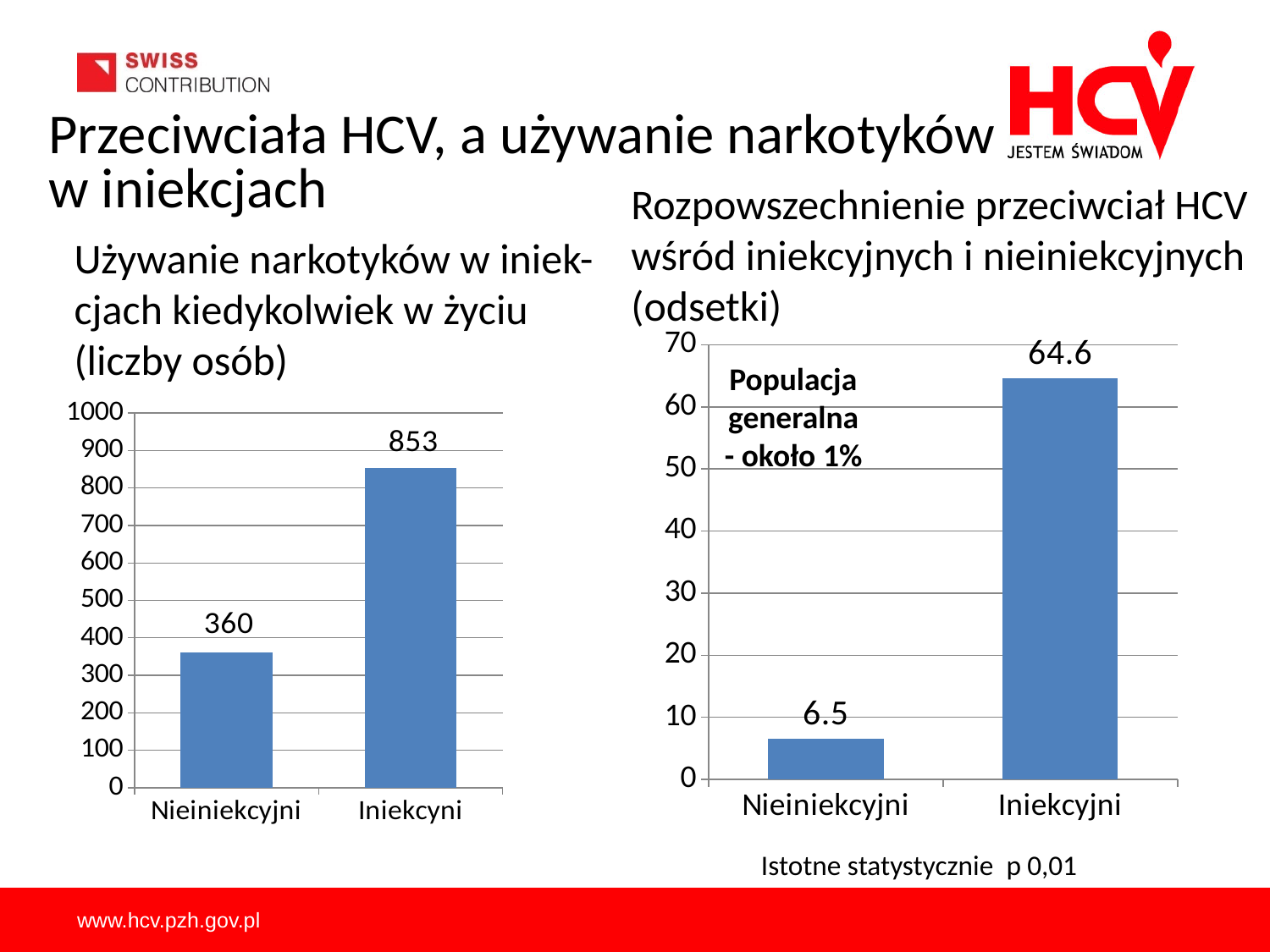
In the right chart, what does the text box inside the plot area say? Populacja generalna - około 1% In the left chart, what is the difference between the values for Iniekcyni and Nieiniekcyjni? 493 In the right chart, is the value for Iniekcyjni greater or less than 60? greater In the left chart, which category has the highest value? Iniekcyni In the right chart (Rozpowszechnienie przeciwciał HCV), what is the value for Iniekcyjni? 64.6 In the left chart (Używanie narkotyków w iniekcjach kiedykolwiek w życiu), what is the value for Nieiniekcyjni? 360 In the left chart (Używanie narkotyków w iniekcjach kiedykolwiek w życiu), what is the value for Iniekcyni? 853 What type of chart is the right chart (Rozpowszechnienie przeciwciał HCV)? bar chart In the right chart, what is the difference between the values for Iniekcyjni and Nieiniekcyjni? 58.1 In the right chart (Rozpowszechnienie przeciwciał HCV), what is the value for Nieiniekcyjni? 6.5 In the right chart, which category has the lowest value? Nieiniekcyjni How many categories are shown in the left chart? 2